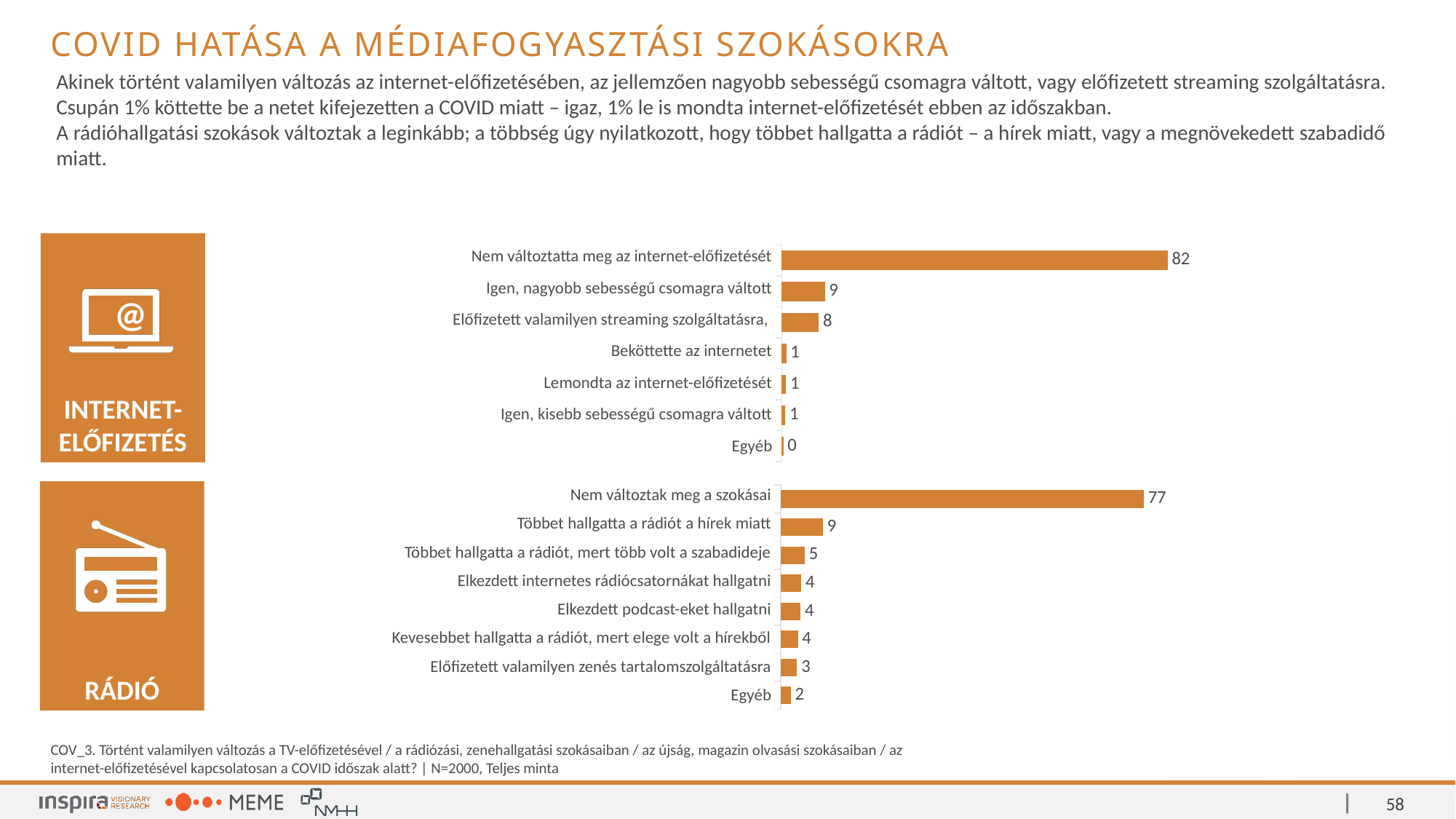
In the Rádió chart, what is the value for "Nem változtak meg a szokásai"? 77 In the Rádió chart, which is larger: "Többet hallgatta a rádiót a hírek miatt" or "Előfizetett valamilyen zenés tartalomszolgáltatásra"? Többet hallgatta a rádiót a hírek miatt In the Rádió chart, what is the value for "Többet hallgatta a rádiót, mert több volt a szabadideje"? 5 In the Internet-előfizetés chart, how many categories are shown? 7 In the Rádió chart, how many categories are shown? 8 In the Rádió chart, which category has the highest value? Nem változtak meg a szokásai What type of chart is the Rádió chart? Bar chart In the Internet-előfizetés chart, what is the value for "Nem változtatta meg az internet-előfizetését"? 82 In the Internet-előfizetés chart, what is the difference between "Igen, nagyobb sebességű csomagra váltott" and "Igen, kisebb sebességű csomagra váltott"? 8 In the Rádió chart, what is the difference between "Nem változtak meg a szokásai" and "Többet hallgatta a rádiót a hírek miatt"? 68 In the Internet-előfizetés chart, what is the value for "Előfizetett valamilyen streaming szolgáltatásra"? 8 In the Internet-előfizetés chart, which category has the lowest value? Egyéb